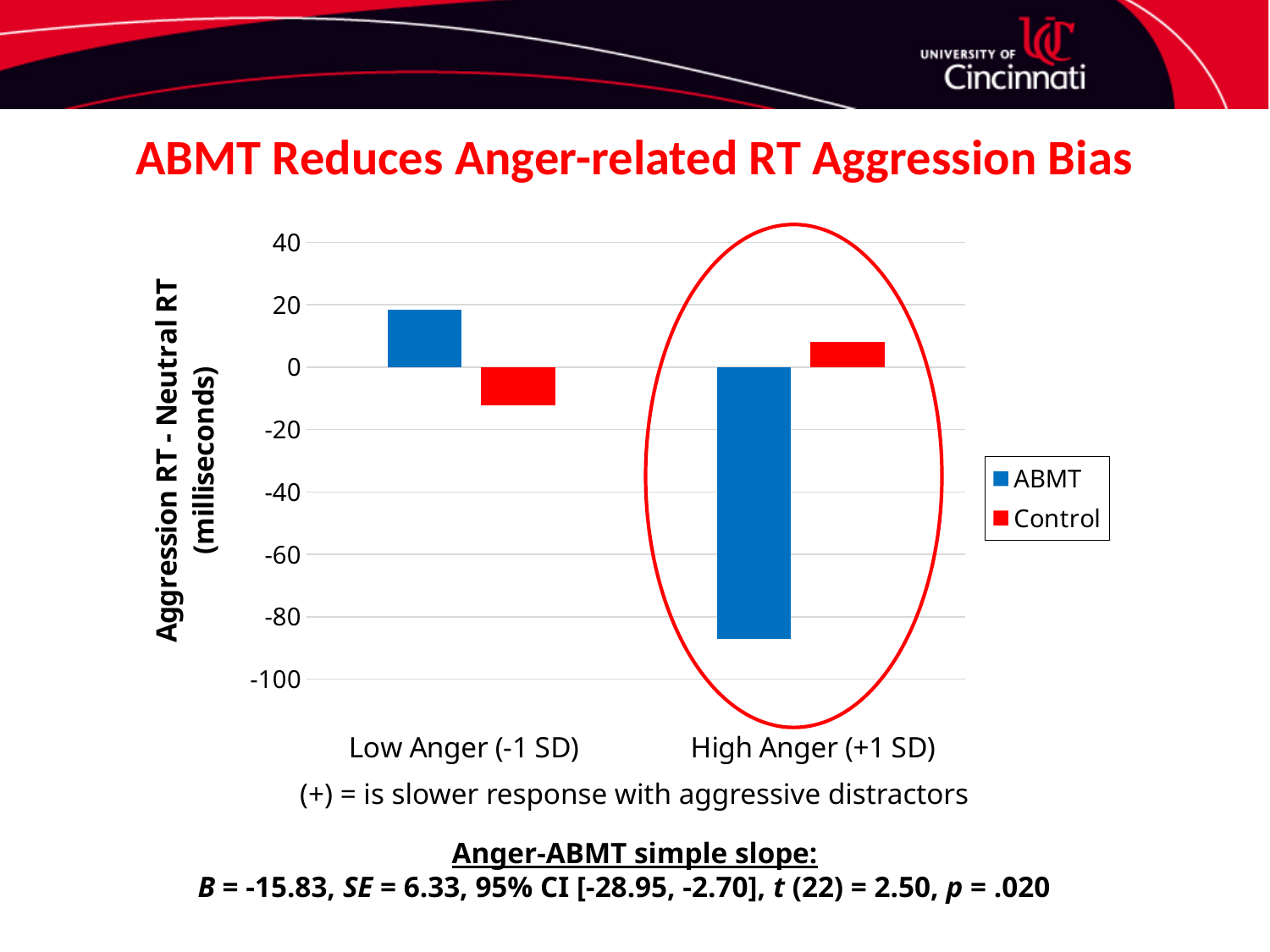
Is the Control value for High Anger (+1 SD) greater or less than 20? less How many categories are shown on the x axis? 2 Which is larger for High Anger (+1 SD): the ABMT value or the Control value? Control How many series does the legend list? 2 Does the ABMT series rise or fall from Low Anger (-1 SD) to High Anger (+1 SD)? fall What kind of chart is shown on the slide? bar chart Is the ABMT value for High Anger (+1 SD) greater or less than -60? less Is the ABMT value for Low Anger (-1 SD) greater or less than 0? greater Which category has the lowest ABMT value? High Anger (+1 SD) What colour represents the Control series in the legend? red Which is larger for Low Anger (-1 SD): the ABMT value or the Control value? ABMT